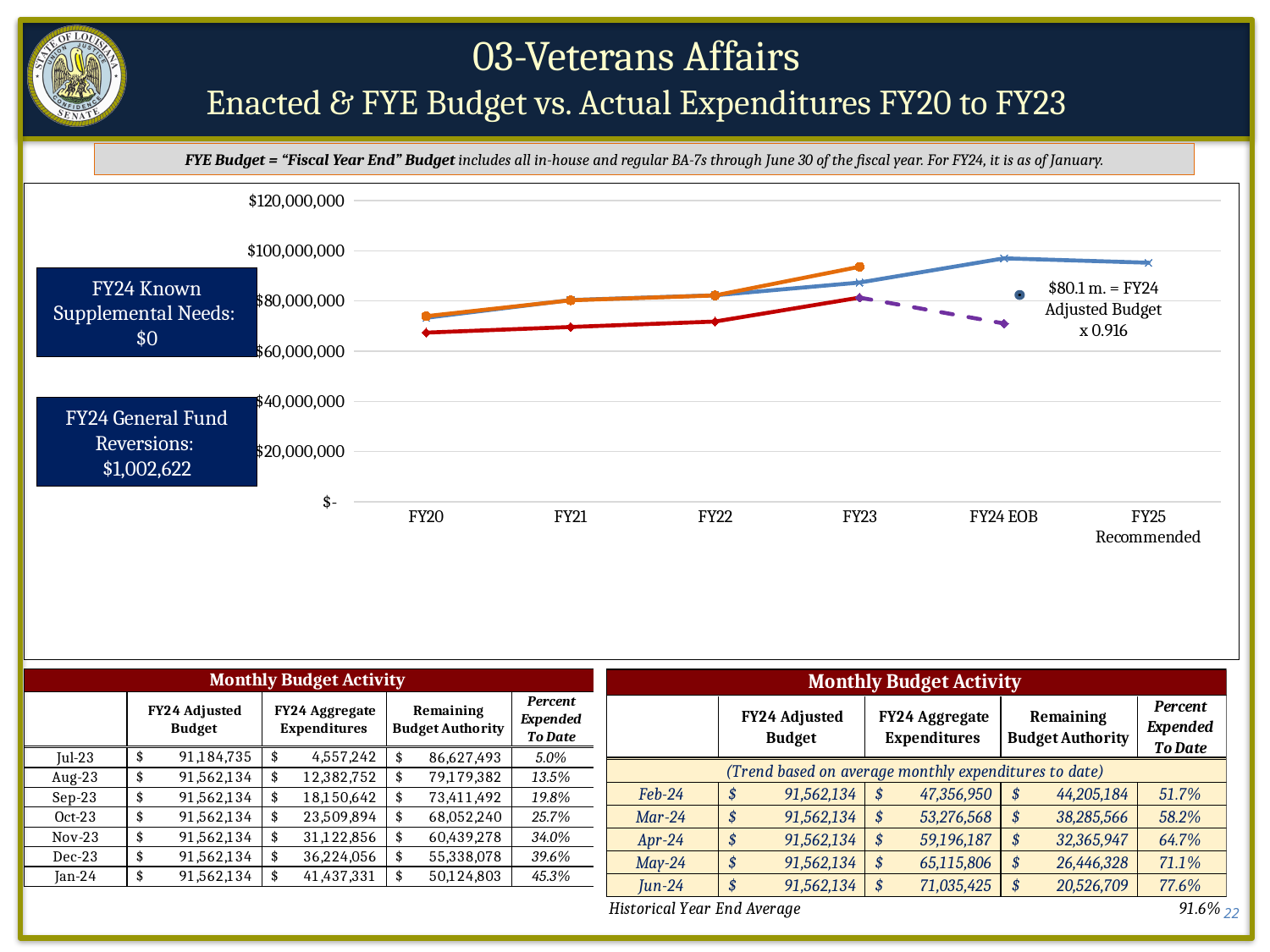
Is the value of the orange line at FY23 greater or less than $80,000,000? greater What does the annotation next to the chart say the $80.1 m. figure represents? FY24 Adjusted Budget x 0.916 Is the value of the purple dashed line at FY24 EOB greater or less than $80,000,000? less Is the value of the orange line at FY20 greater or less than $80,000,000? less At FY24 EOB, which line has the higher value, the blue line or the purple dashed line? blue line At FY20, which line has the higher value, the orange line or the red line? orange line What kind of chart is shown on the slide? line chart What is the highest value labelled on the chart's y axis? $120,000,000 How many fiscal-year categories are shown on the x axis of the chart? 6 Does the red line rise or fall from FY20 to FY23? rise